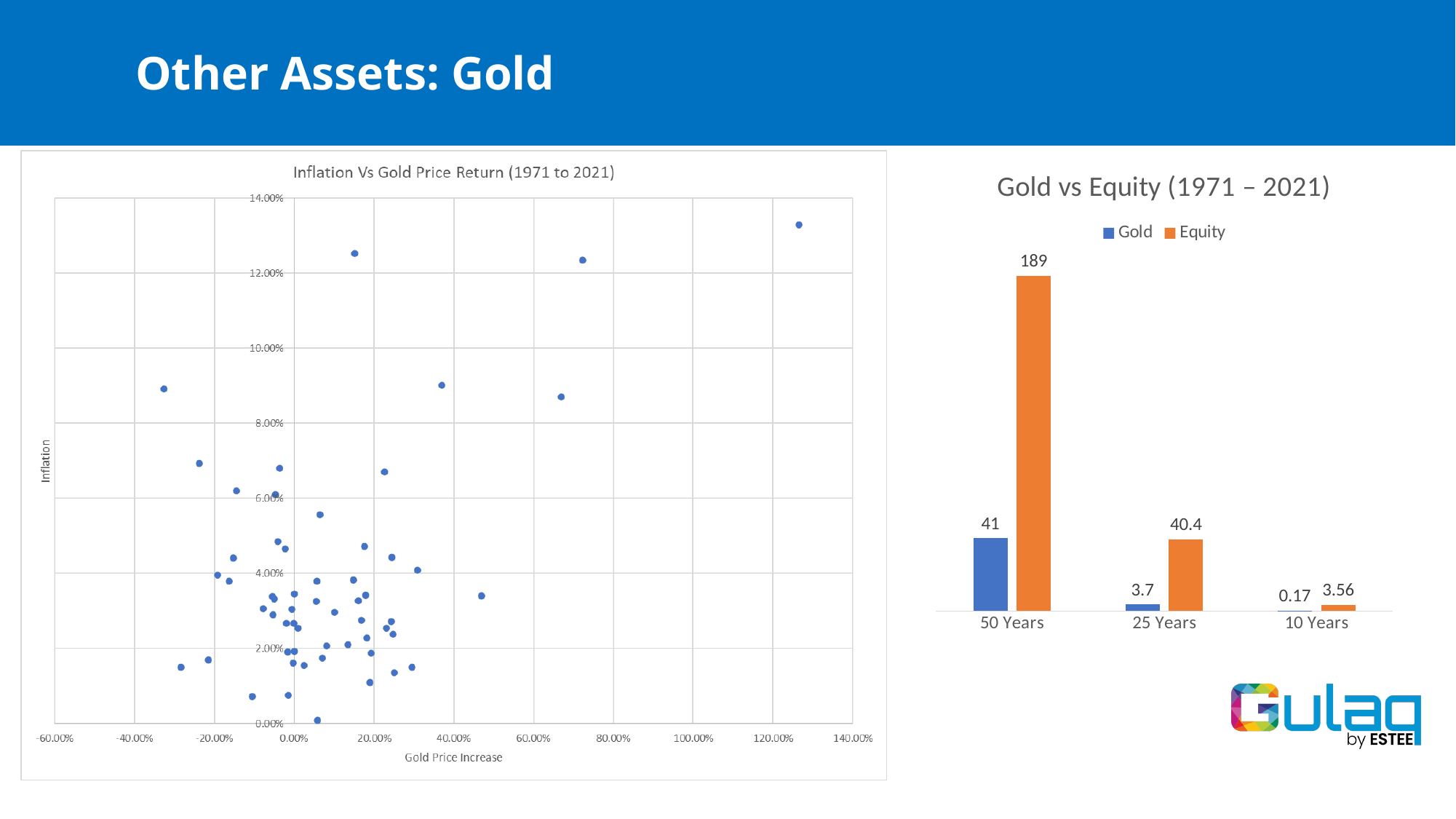
In the 'Gold vs Equity (1971 – 2021)' chart, what is the difference between the Equity and Gold values at 50 Years? 148 In the 'Gold vs Equity (1971 – 2021)' chart, how many series does the legend list? 2 What kind of chart is the 'Inflation Vs Gold Price Return (1971 to 2021)' chart on the left? Scatter chart In the 'Gold vs Equity (1971 – 2021)' chart, what is the value for Equity at 10 Years? 3.56 In the 'Gold vs Equity (1971 – 2021)' chart, which is larger at 25 Years, Gold or Equity? Equity What is the x-axis label of the 'Inflation Vs Gold Price Return (1971 to 2021)' chart? Gold Price Increase In the 'Gold vs Equity (1971 – 2021)' chart, what is the value for Equity at 50 Years? 189 In the 'Gold vs Equity (1971 – 2021)' chart, what is the value for Gold at 10 Years? 0.17 In the 'Gold vs Equity (1971 – 2021)' chart, how many periods are shown on the x axis? 3 In the 'Gold vs Equity (1971 – 2021)' chart, which period has the lowest Equity value? 10 Years In the 'Gold vs Equity (1971 – 2021)' chart, which period has the highest Gold value? 50 Years In the 'Gold vs Equity (1971 – 2021)' chart, what is the value for Gold at 25 Years? 3.7